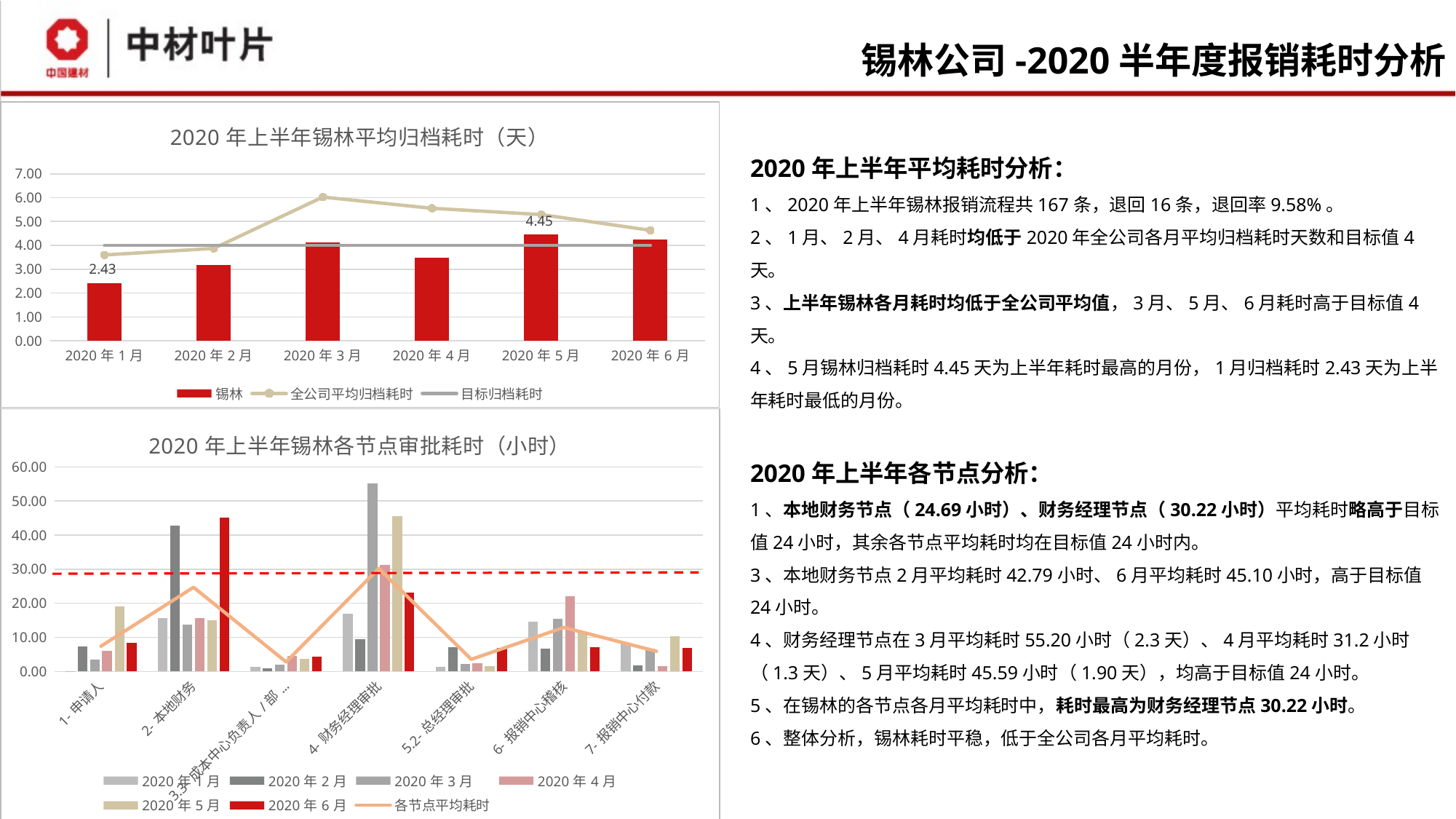
In the bottom chart '2020年上半年锡林各节点审批耗时（小时）', is the 2020年3月 value for 4-财务经理审批 greater or less than 50.00? greater In the bottom chart '2020年上半年锡林各节点审批耗时（小时）', how many series does the legend list? 7 In the top chart '2020年上半年锡林平均归档耗时（天）', how many series does the legend list? 3 In the top chart '2020年上半年锡林平均归档耗时（天）', how many months are shown on the x axis? 6 In the top chart '2020年上半年锡林平均归档耗时（天）', is the 锡林 value for 2020年2月 greater or less than 4.00? less In the top chart '2020年上半年锡林平均归档耗时（天）', does the 全公司平均归档耗时 line rise or fall from 2020年3月 to 2020年6月? fall In the top chart '2020年上半年锡林平均归档耗时（天）', which month has the lowest 锡林 bar? 2020年1月 In the top chart '2020年上半年锡林平均归档耗时（天）', what is the 锡林 value for 2020年5月? 4.45 In the top chart '2020年上半年锡林平均归档耗时（天）', which month has the highest 锡林 bar? 2020年5月 In the top chart '2020年上半年锡林平均归档耗时（天）', what is the difference between the 锡林 values for 2020年5月 and 2020年1月? 2.02 In the bottom chart '2020年上半年锡林各节点审批耗时（小时）', which month has the tallest bar for 4-财务经理审批? 2020年3月 In the top chart '2020年上半年锡林平均归档耗时（天）', what is the 锡林 value for 2020年1月? 2.43